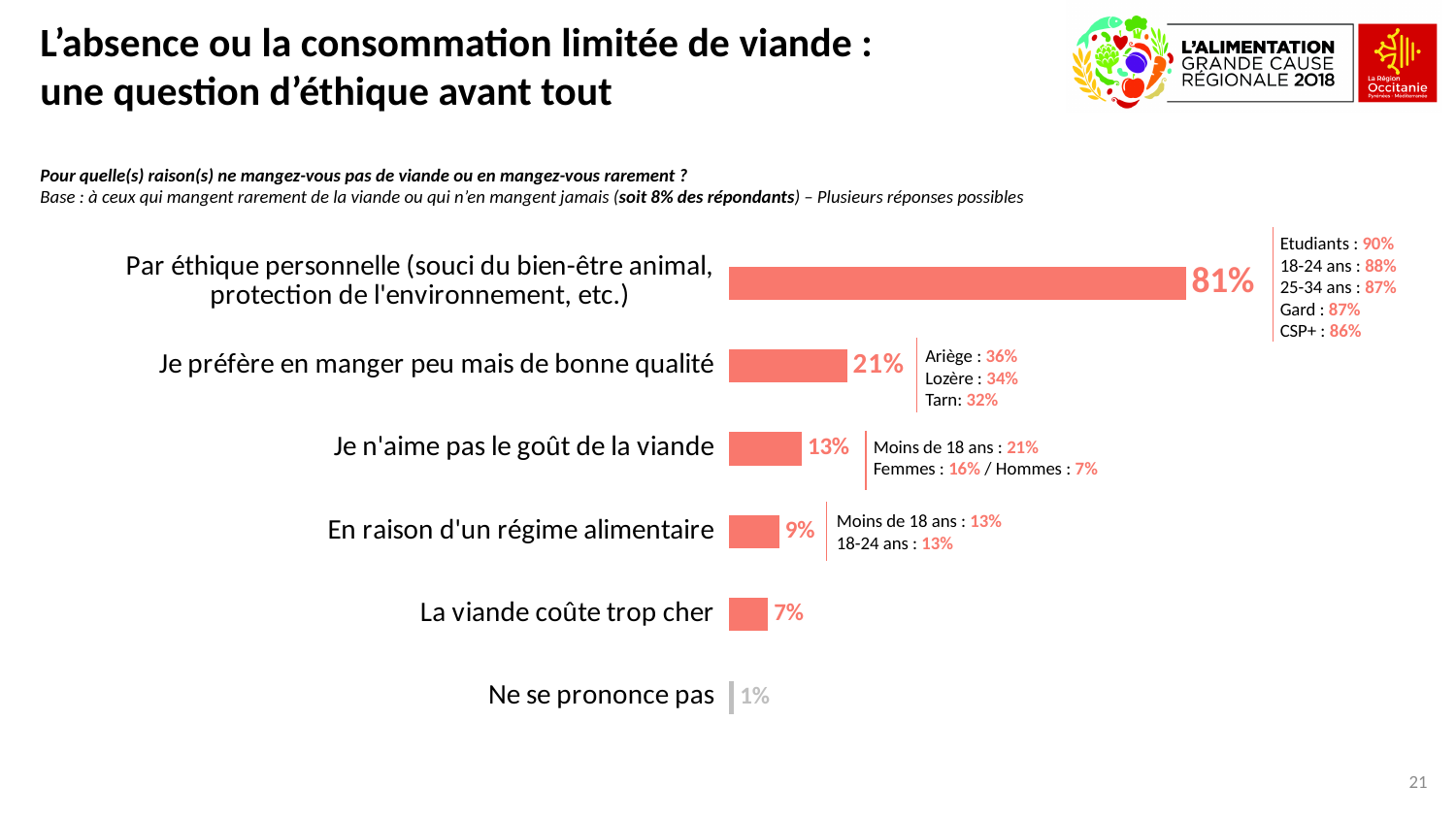
What is the value for 'Je préfère en manger peu mais de bonne qualité'? 21% According to the annotation next to the top bar, what percentage of students (Etudiants) cite personal ethics? 90% Which is larger: 'En raison d'un régime alimentaire' or 'La viande coûte trop cher'? En raison d'un régime alimentaire Which reason has the highest percentage? Par éthique personnelle (souci du bien-être animal, protection de l'environnement, etc.) What is the value for 'Je n'aime pas le goût de la viande'? 13% What is the difference between 'Je n'aime pas le goût de la viande' and 'En raison d'un régime alimentaire'? 4 percentage points Which category has the lowest percentage? Ne se prononce pas How many categories are shown in the chart? 6 What is the value for 'La viande coûte trop cher'? 7% What percentage of respondents cite 'Par éthique personnelle (souci du bien-être animal, protection de l'environnement, etc.)' as a reason? 81% What is the difference between 'Par éthique personnelle' and 'Je préfère en manger peu mais de bonne qualité'? 60 percentage points What kind of chart is shown on the slide? Bar chart